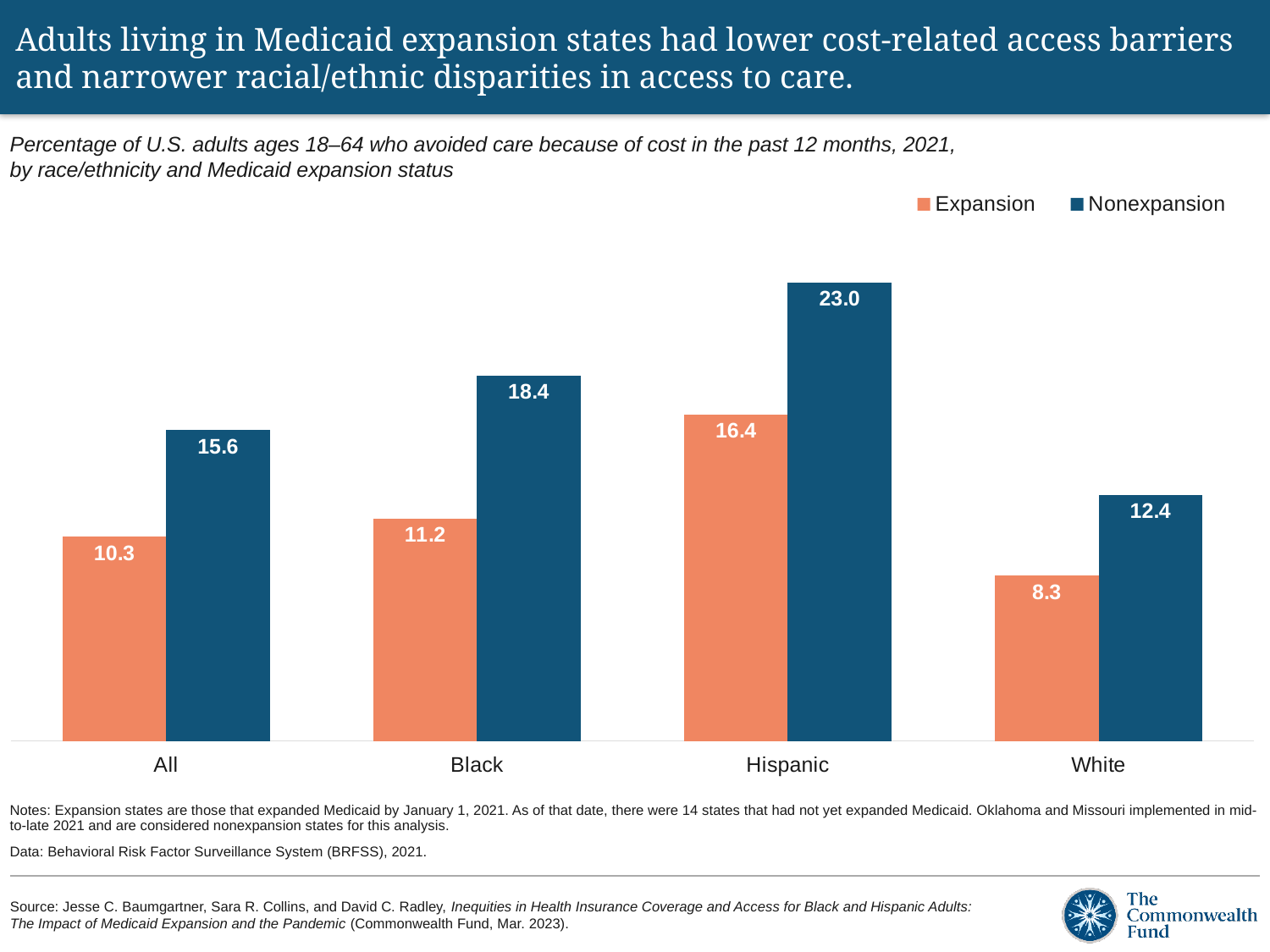
What is the difference between the Nonexpansion and Expansion values for Black adults? 7.2 What is the Nonexpansion value for Black adults? 18.4 Which race/ethnicity category has the highest Nonexpansion value? Hispanic How many series does the legend list? 2 How many race/ethnicity categories are shown on the x axis? 4 What is the Expansion value for White adults? 8.3 What is the Expansion value for Hispanic adults? 16.4 What is the Nonexpansion value for the All category? 15.6 Which is larger: the Expansion value for Black adults or the Nonexpansion value for White adults? Nonexpansion value for White adults Which race/ethnicity category has the lowest Expansion value? White What is the difference between the Nonexpansion and Expansion values for Hispanic adults? 6.6 What kind of chart is shown on the slide? Bar chart